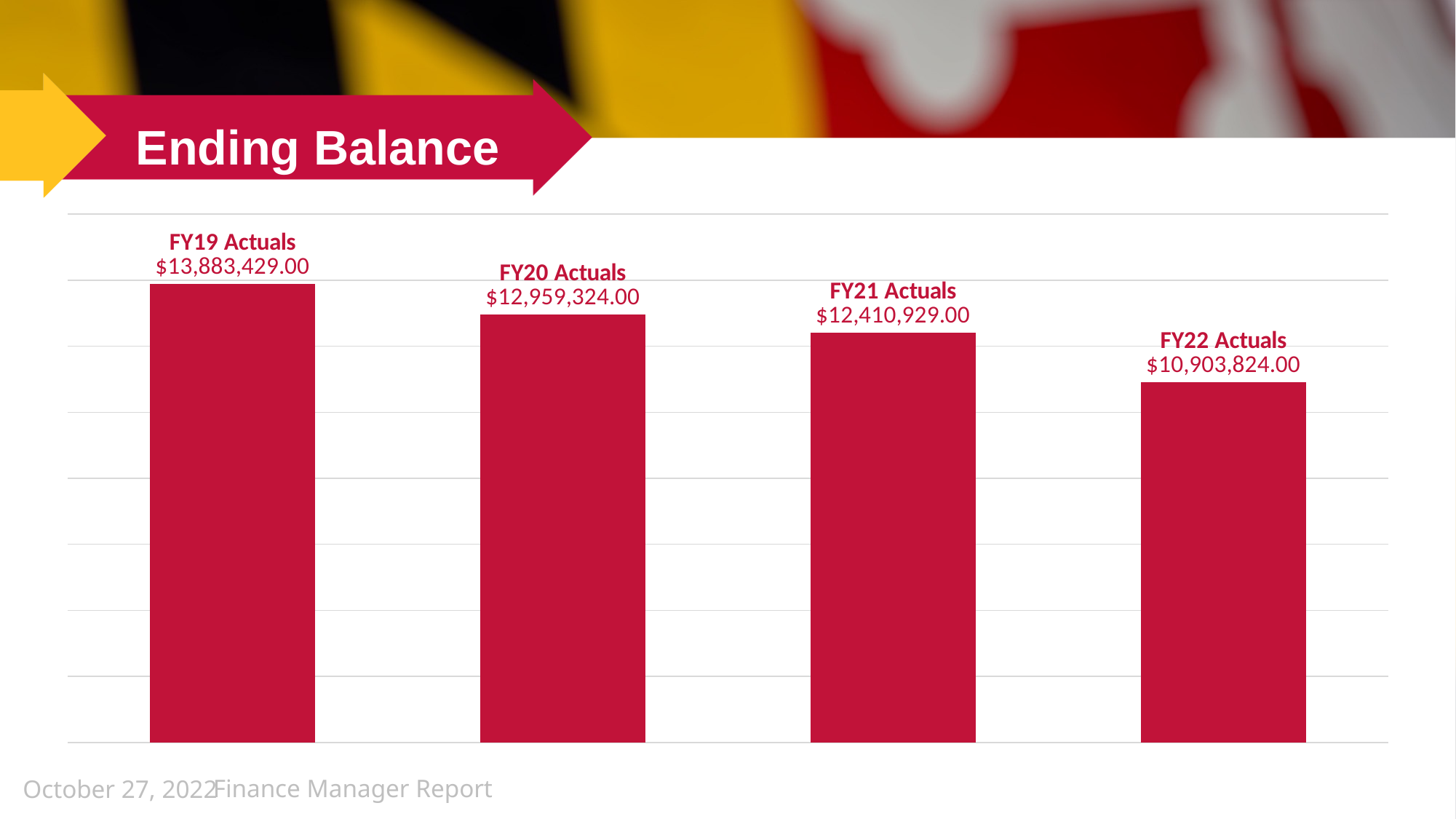
What is the value for FY19 Actuals? $13,883,429.00 What is the difference between the FY21 Actuals and FY22 Actuals values? $1,507,105.00 Do the values rise or fall from FY19 to FY22? Fall What is the value for FY21 Actuals? $12,410,929.00 What kind of chart is shown on the slide? Bar chart What is the difference between the FY19 Actuals and FY20 Actuals values? $924,105.00 Which fiscal year has the lowest ending balance? FY22 Actuals Which fiscal year has the highest ending balance? FY19 Actuals How many bars are shown in the chart? 4 What is the title of the slide containing the chart? Ending Balance What is the value for FY22 Actuals? $10,903,824.00 Which is larger, the value for FY20 Actuals or FY21 Actuals? FY20 Actuals